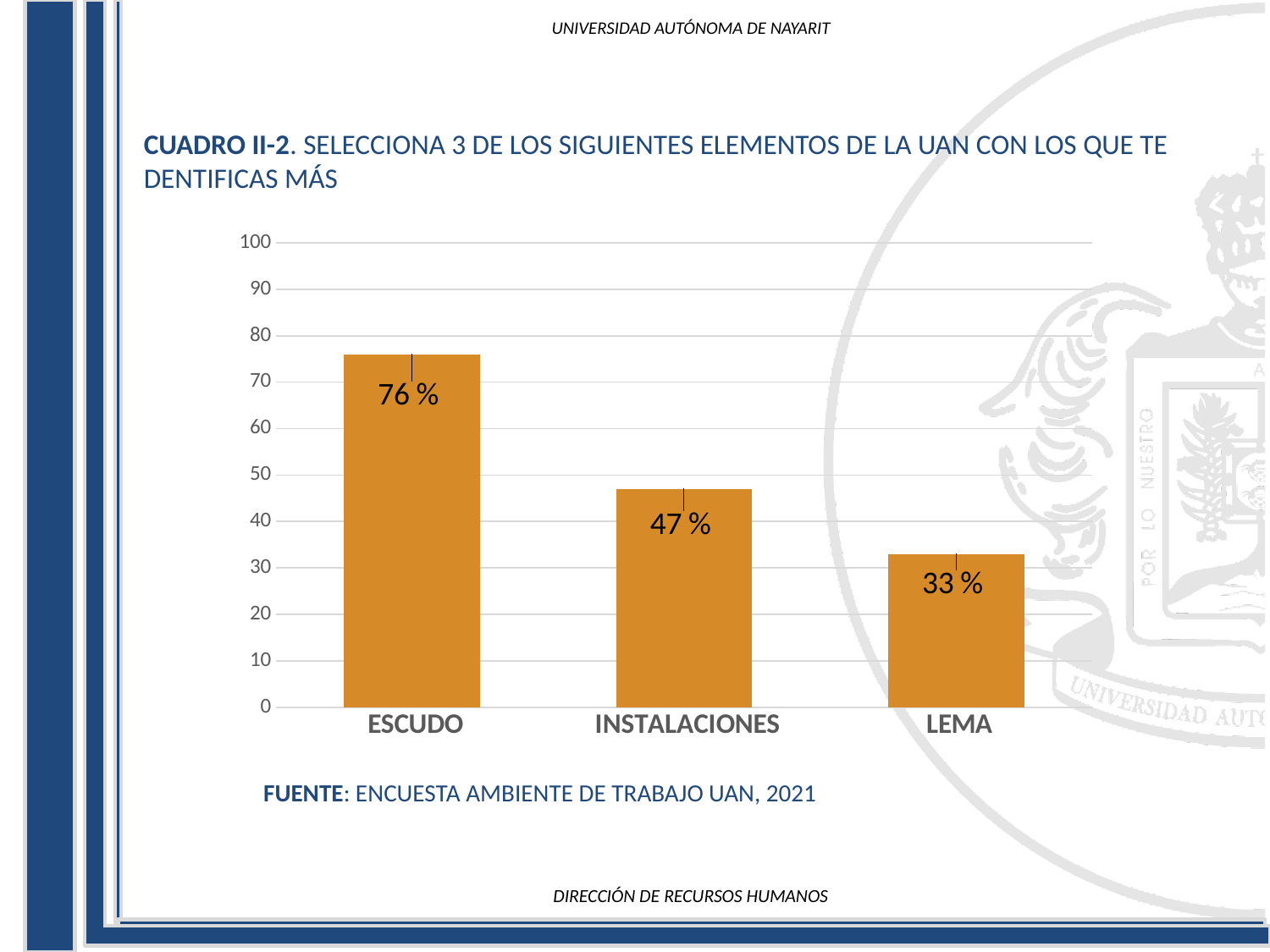
Is the value for ESCUDO greater or less than 70? greater What is the difference between the values for INSTALACIONES and LEMA? 14 % What is the value for LEMA? 33 % Which is larger, the value for INSTALACIONES or the value for LEMA? INSTALACIONES Which category has the lowest value? LEMA Which category has the highest value? ESCUDO How many categories are shown in the chart? 3 What is the difference between the values for ESCUDO and INSTALACIONES? 29 % What kind of chart is shown on the slide? Bar chart Do the values rise or fall from left to right across the categories? Fall What is the value for ESCUDO? 76 % What is the value for INSTALACIONES? 47 %